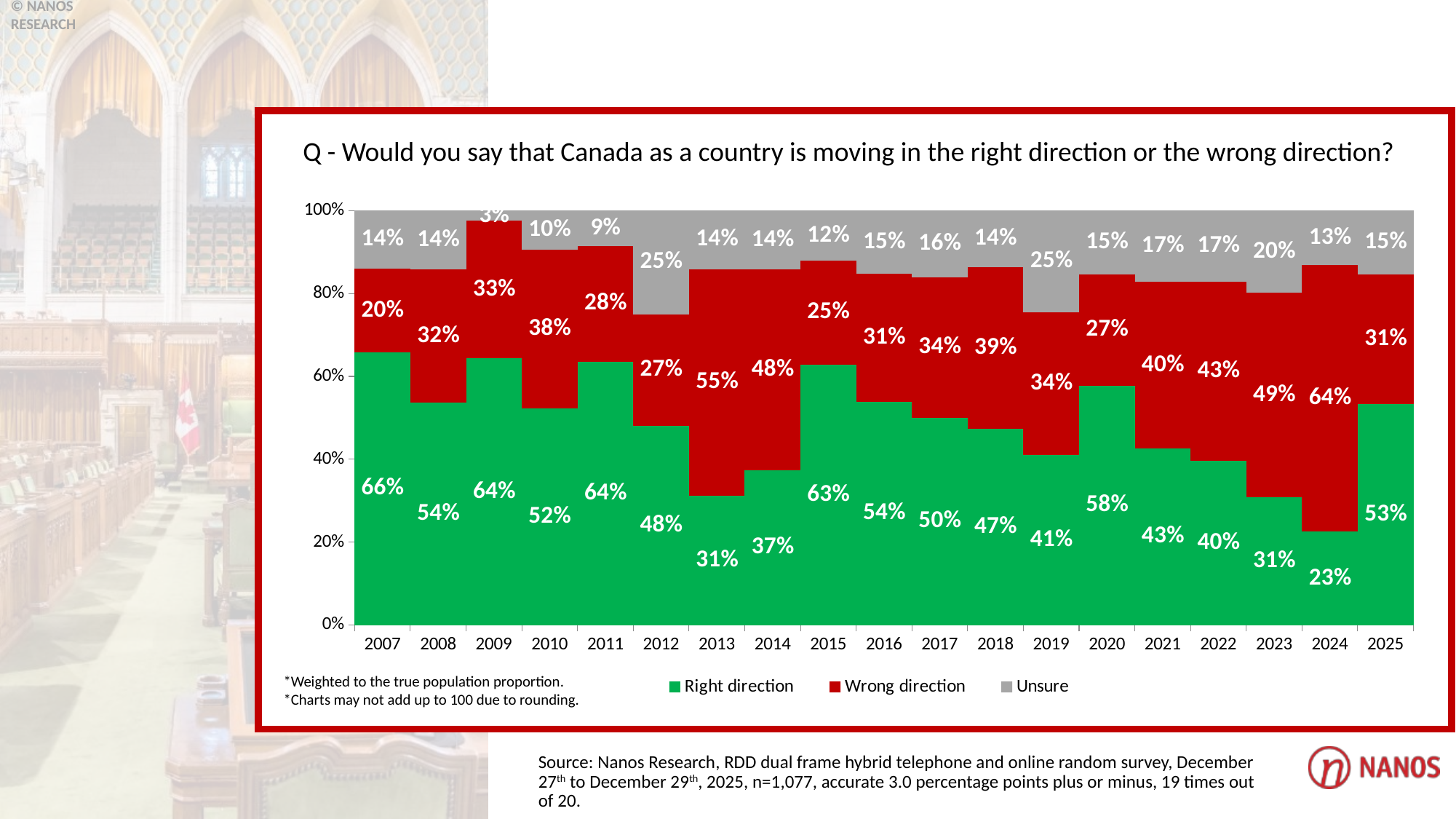
By how many percentage points did the 'Right direction' share change from 2024 to 2025? 30 percentage points What percentage said Canada is moving in the wrong direction in 2024? 64% Did the 'Right direction' share rise or fall from 2020 to 2024? Fall In which year was the 'Right direction' share lowest? 2024 What kind of chart is shown on the slide? 100% stacked bar chart How many series does the legend list? 3 In which year was the 'Unsure' share lowest? 2009 Which year had a larger 'Wrong direction' share, 2013 or 2014? 2013 What percentage said Canada is moving in the right direction in 2025? 53% How many years are shown on the x axis? 19 What percentage were unsure in 2012? 25% In which year was the 'Right direction' share highest? 2007